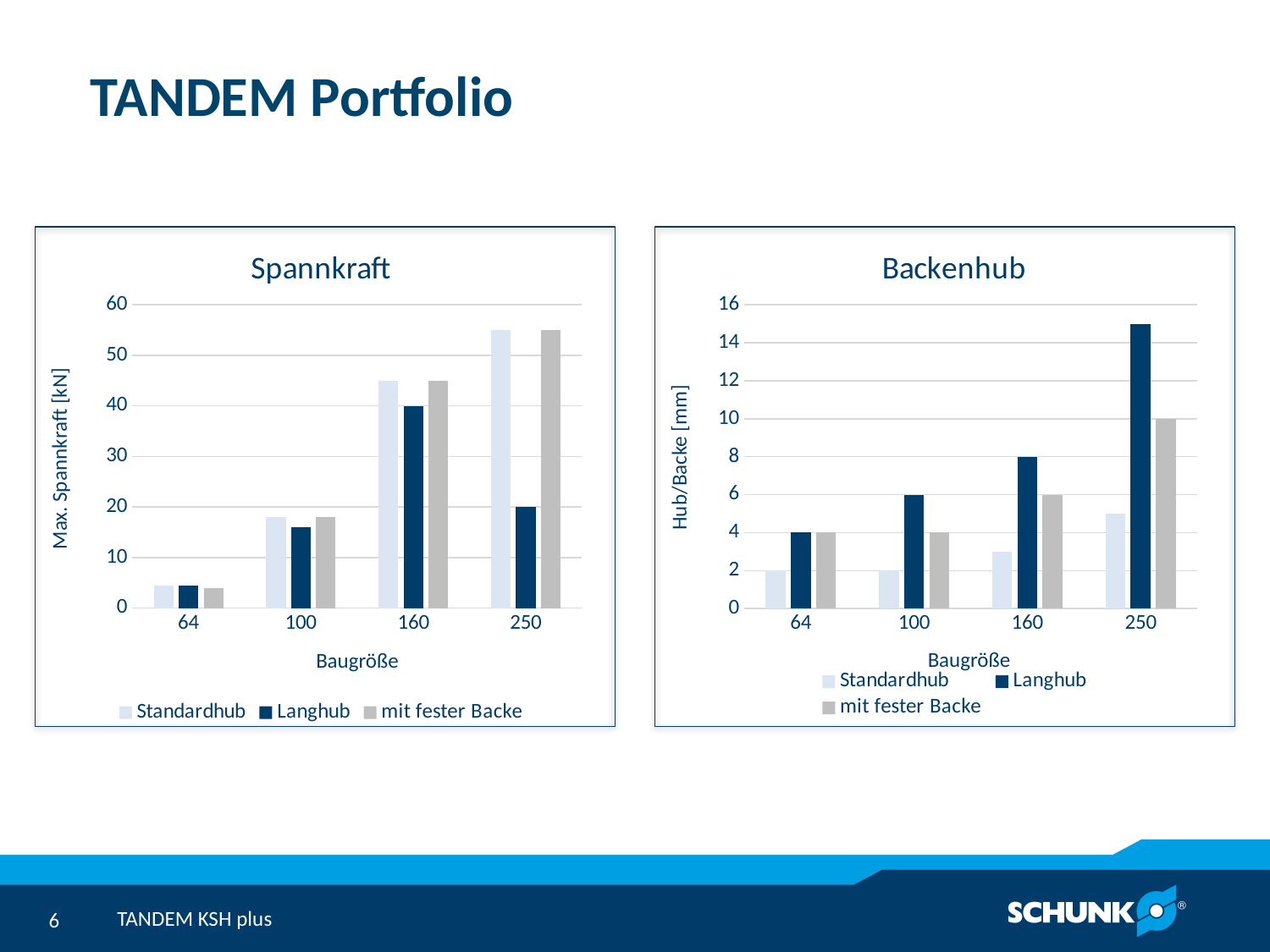
What is the y-axis label of the Backenhub chart? Hub/Backe [mm] In the Spannkraft chart, how many Baugröße categories are shown on the x axis? 4 In the Spannkraft chart, which Baugröße has the lowest Langhub value? 64 What kind of chart is the Spannkraft chart? bar chart In the Spannkraft chart, what is the Langhub value for Baugröße 160? 40 In the Backenhub chart, which Baugröße has the highest Langhub value? 250 In the Backenhub chart, what is the mit fester Backe value for Baugröße 250? 10 In the Spannkraft chart, how many series does the legend list? 3 In the Spannkraft chart, which is larger for Baugröße 250: Standardhub or Langhub? Standardhub In the Backenhub chart, what is the difference between the Langhub and mit fester Backe values for Baugröße 100? 2 In the Backenhub chart, what is the Langhub value for Baugröße 160? 8 In the Spannkraft chart, is the Standardhub value for Baugröße 250 greater or less than 50? greater